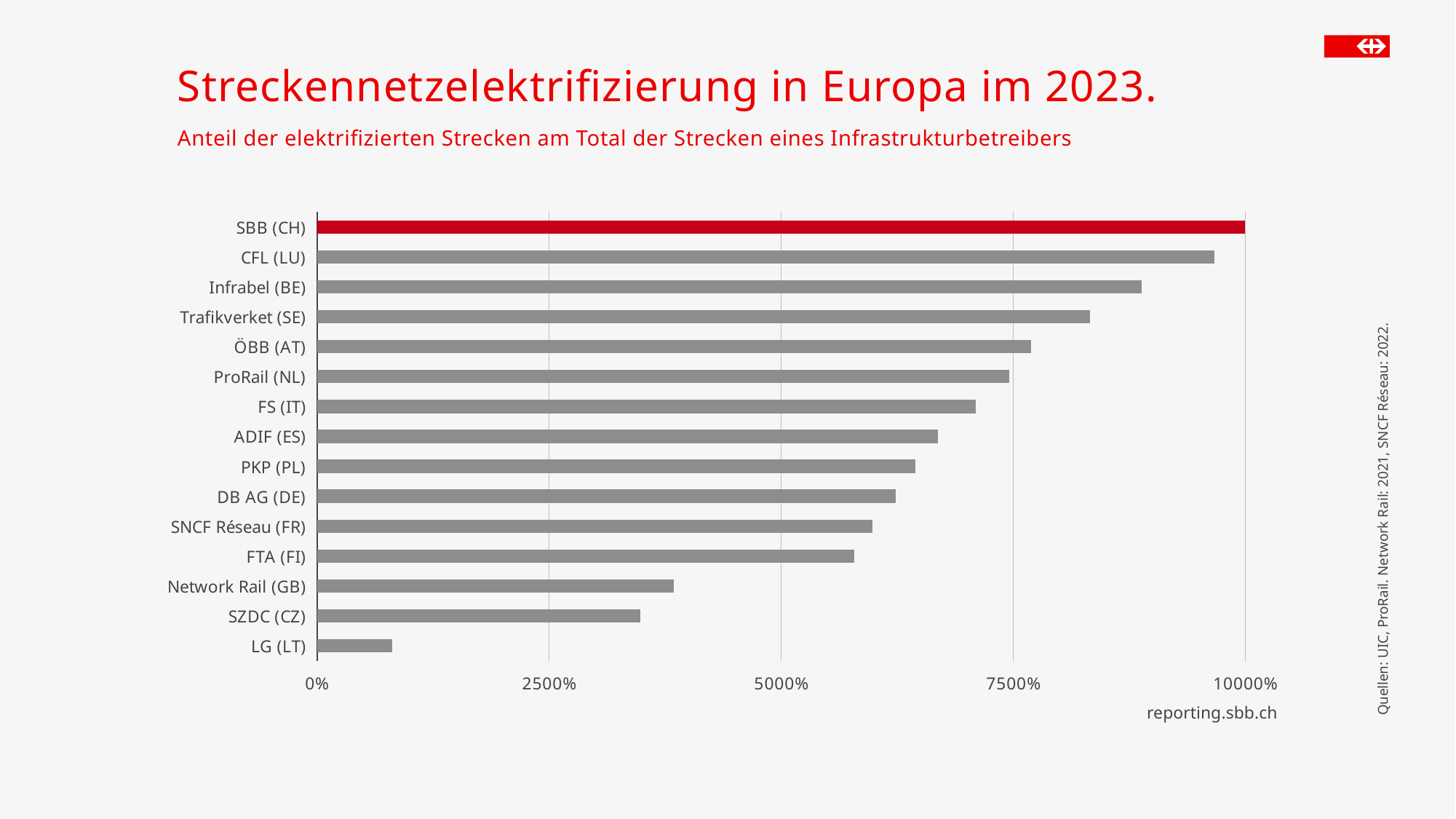
Which has the larger value, Network Rail (GB) or SZDC (CZ)? Network Rail (GB) Is the value for LG (LT) greater or less than 2500%? less Is the value for Trafikverket (SE) greater or less than 7500%? greater What colour is the bar for SBB (CH)? red Which operator has the highest value in the chart? SBB (CH) What kind of chart is shown on the slide? bar chart Is the value for FS (IT) greater or less than 5000%? greater How many infrastructure operators (categories) are shown in the chart? 15 Which operator has the lowest value in the chart? LG (LT) Which has the larger value, CFL (LU) or Infrabel (BE)? CFL (LU)